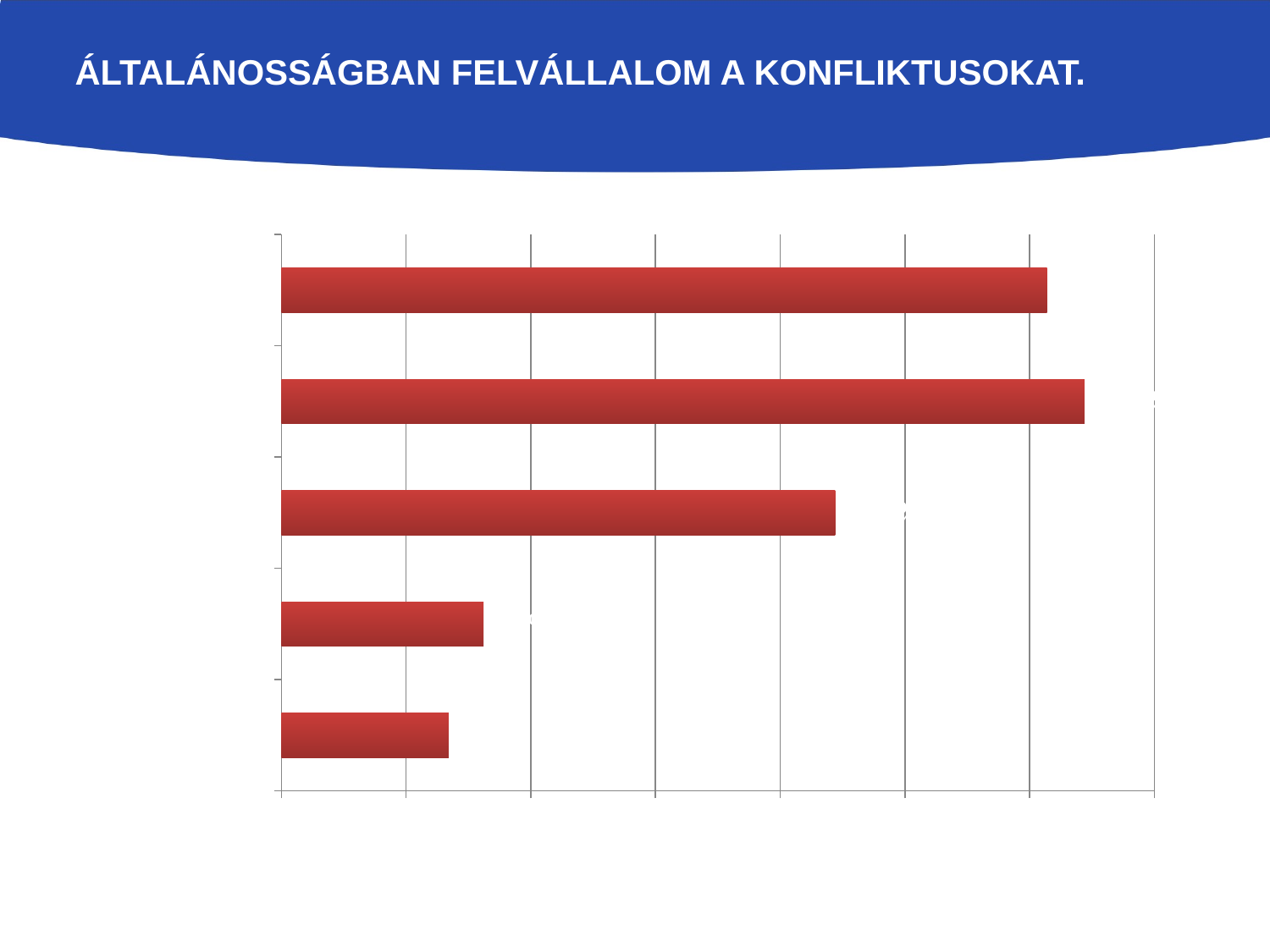
What colour are the bars in the chart? red Which bar is the longest: the top bar, the second bar from the top, the middle bar, the fourth bar, or the bottom bar? the second bar from the top Which is longer, the fourth bar from the top or the bottom bar? the fourth bar from the top What kind of chart is shown on the slide? bar chart How many bars does the chart contain? 5 Are the bars in the chart horizontal or vertical? horizontal Which bar is the shortest: the top bar, the second bar from the top, the middle bar, the fourth bar, or the bottom bar? the bottom bar Which is longer, the middle bar or the fourth bar from the top? the middle bar Which is longer, the top bar or the middle bar? the top bar